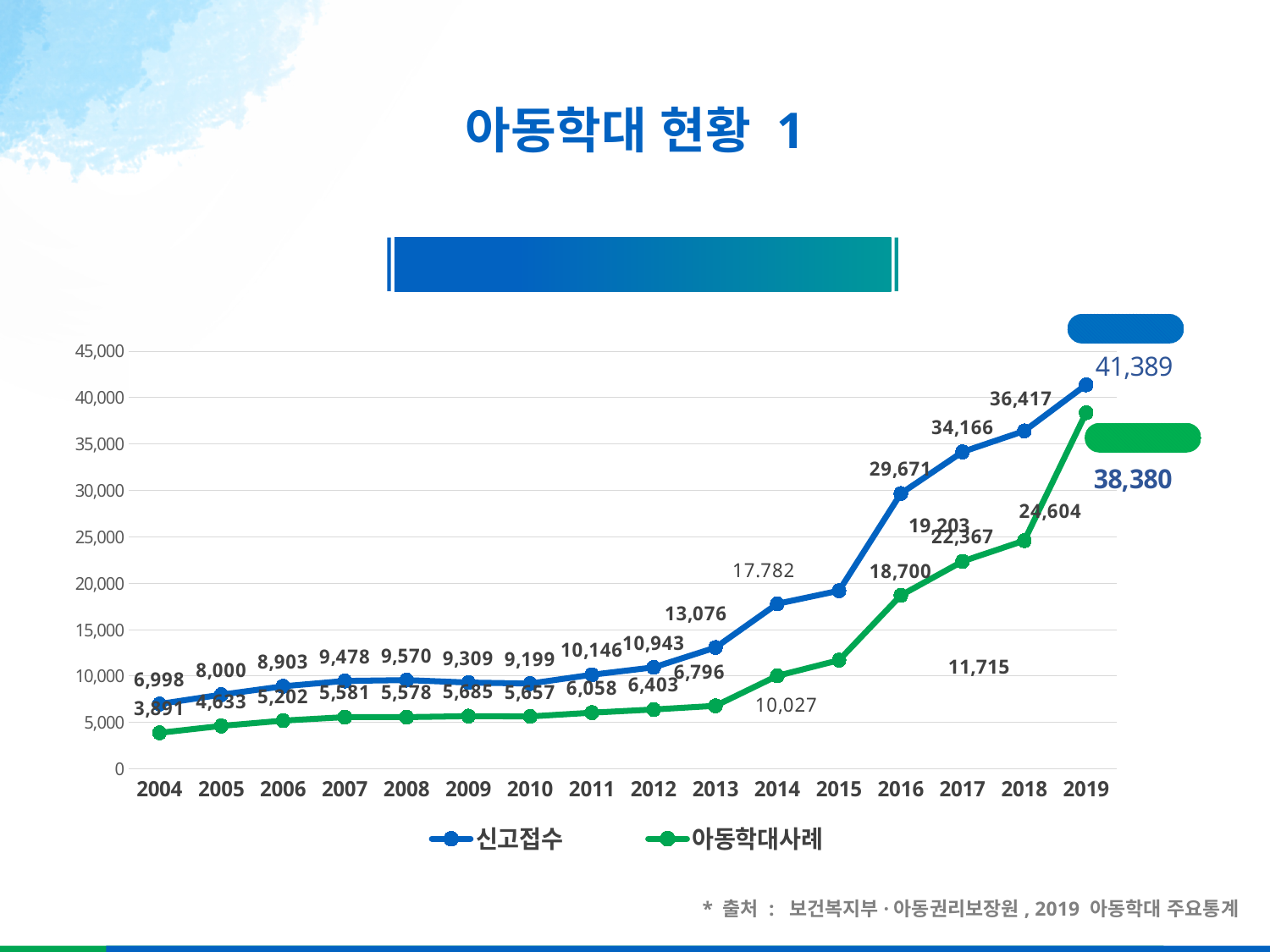
How many series does the legend list? 2 What is the value of 아동학대사례 in 2016? 18,700 What is the value of 아동학대사례 in 2018? 24,604 What kind of chart is shown on the slide? line chart In which year is 아동학대사례 lowest? 2004 In which year is 신고접수 highest? 2019 How many years are shown on the x axis? 16 What is the value of 신고접수 in 2013? 13,076 In 2017, which series has the larger value, 신고접수 or 아동학대사례? 신고접수 What is the value of 신고접수 in 2019? 41,389 What is the difference between 신고접수 and 아동학대사례 in 2019? 3,009 By how much did 신고접수 increase from 2018 to 2019? 4,972